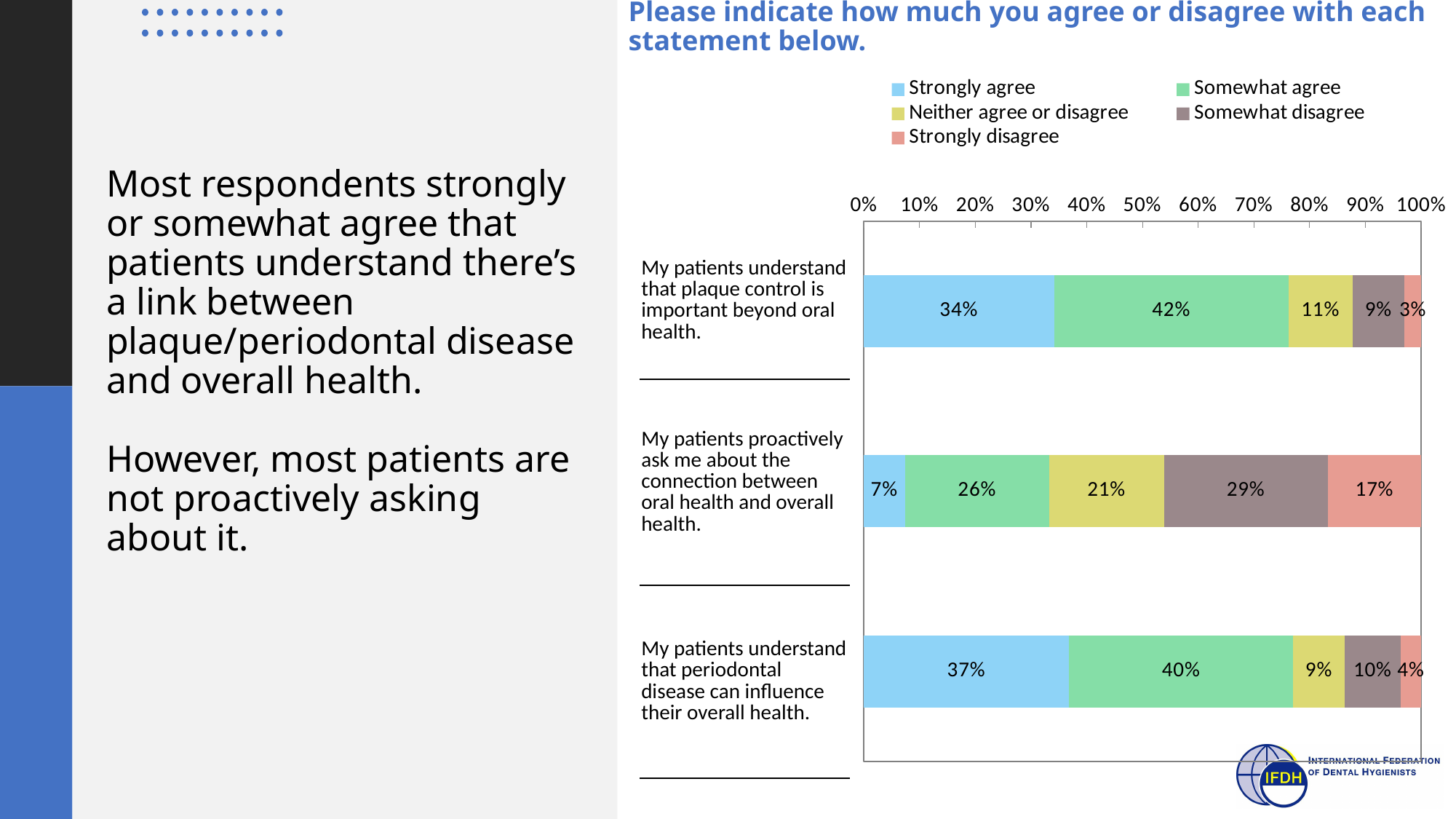
What is the difference between the 'Strongly agree' percentages for the periodontal disease statement (37%) and the plaque control statement (34%)? 3% How many series does the legend list? 5 How many statements are shown in the chart? 3 Which statement has the highest 'Somewhat agree' percentage? My patients understand that plaque control is important beyond oral health. What percentage of respondents strongly agree that their patients understand that plaque control is important beyond oral health? 34% Is the 'Neither agree or disagree' percentage larger for the plaque control statement or for the proactively ask statement? The proactively ask statement What percentage of respondents strongly disagree that their patients proactively ask about the connection between oral health and overall health? 17% Which statement has the lowest 'Strongly agree' percentage? My patients proactively ask me about the connection between oral health and overall health. What percentage of respondents somewhat disagree that their patients proactively ask about the connection between oral health and overall health? 29% What is the combined percentage of 'Strongly agree' and 'Somewhat agree' for the statement that patients understand periodontal disease can influence their overall health? 77% What percentage of respondents strongly agree that their patients understand that periodontal disease can influence their overall health? 37% What type of chart is shown on the slide? Stacked bar chart